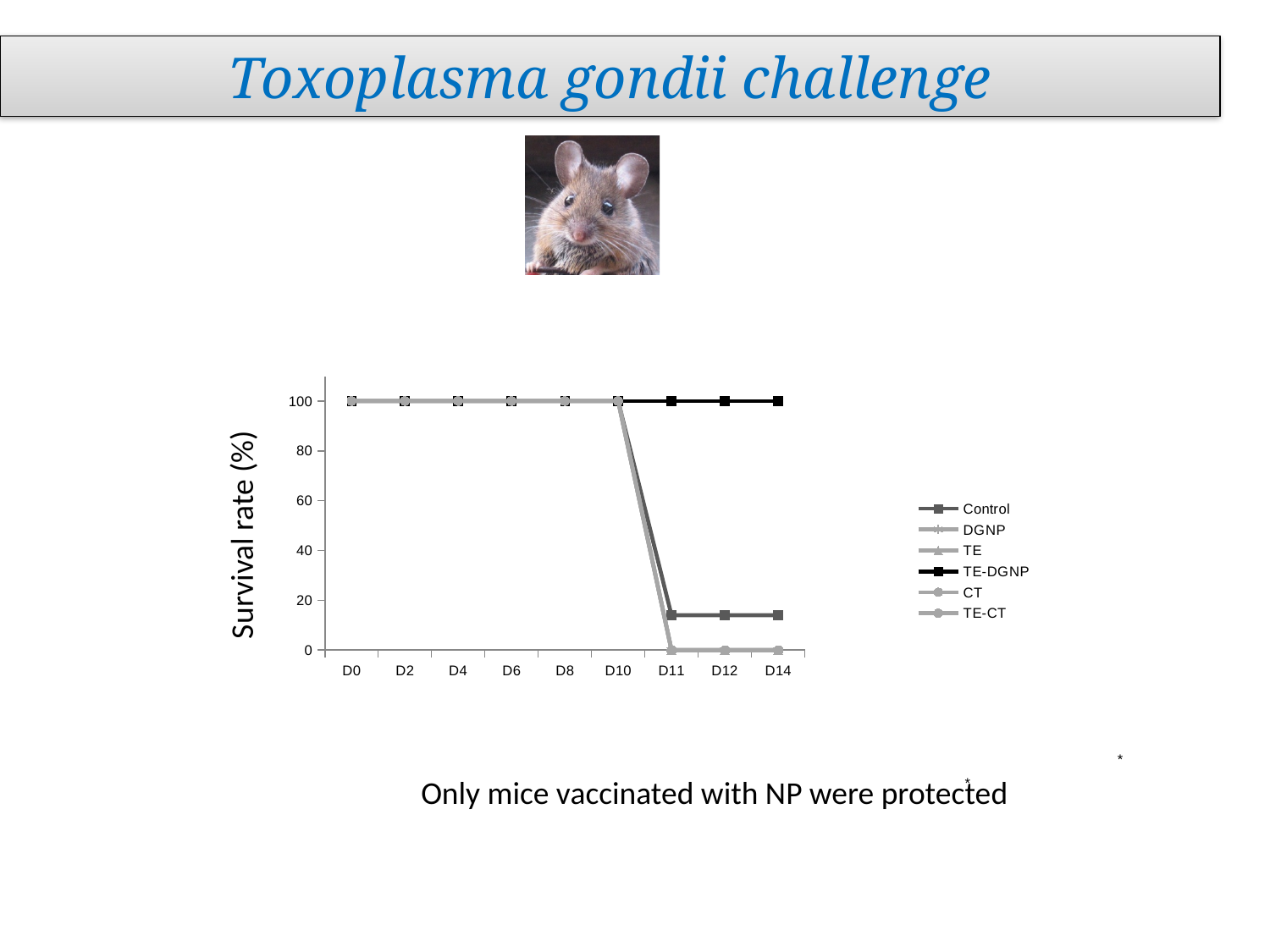
Is the survival rate for the Control group at D14 greater or less than 20? less What is the survival rate for TE-DGNP at D14? 100 Does the Control line rise or fall between D10 and D11? fall What is the survival rate for TE at D14? 0 What kind of chart is shown on the slide? line chart What is the survival rate for the Control group at D0? 100 How many time points are labelled on the x axis? 9 Which series has the highest survival rate at D14? TE-DGNP How many series does the legend list? 6 At which labelled day does the Control line first drop below 100? D11 What is the label on the y axis? Survival rate (%) At D12, which is larger: the survival rate for TE-DGNP or for Control? TE-DGNP